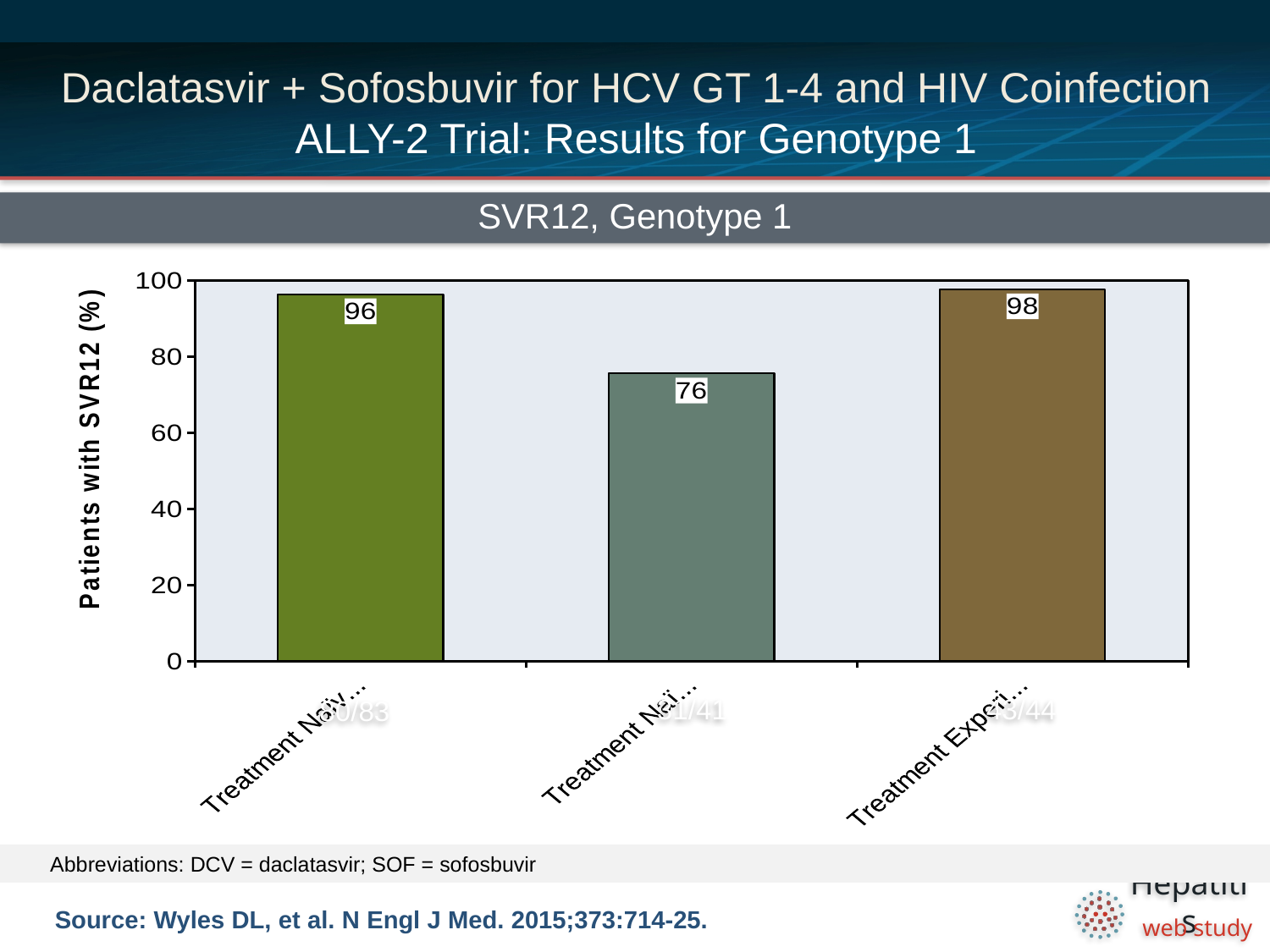
Which bar has the highest value in the SVR12, Genotype 1 chart: left, middle or right? right How many bars are plotted in the SVR12, Genotype 1 chart? 3 What is the value of the right bar in the SVR12, Genotype 1 chart? 98 What is the value of the middle bar in the SVR12, Genotype 1 chart? 76 Is the value of the middle bar in the SVR12, Genotype 1 chart greater or less than 80? less Which is larger in the SVR12, Genotype 1 chart: the left bar or the middle bar? the left bar What kind of chart is shown on the slide? bar chart What is the value of the left bar in the SVR12, Genotype 1 chart? 96 What is the difference between the right bar and the middle bar in the SVR12, Genotype 1 chart? 22 Which bar has the lowest value in the SVR12, Genotype 1 chart: left, middle or right? middle What is the y-axis label of the SVR12, Genotype 1 chart? Patients with SVR12 (%) What is the difference between the left bar and the middle bar in the SVR12, Genotype 1 chart? 20